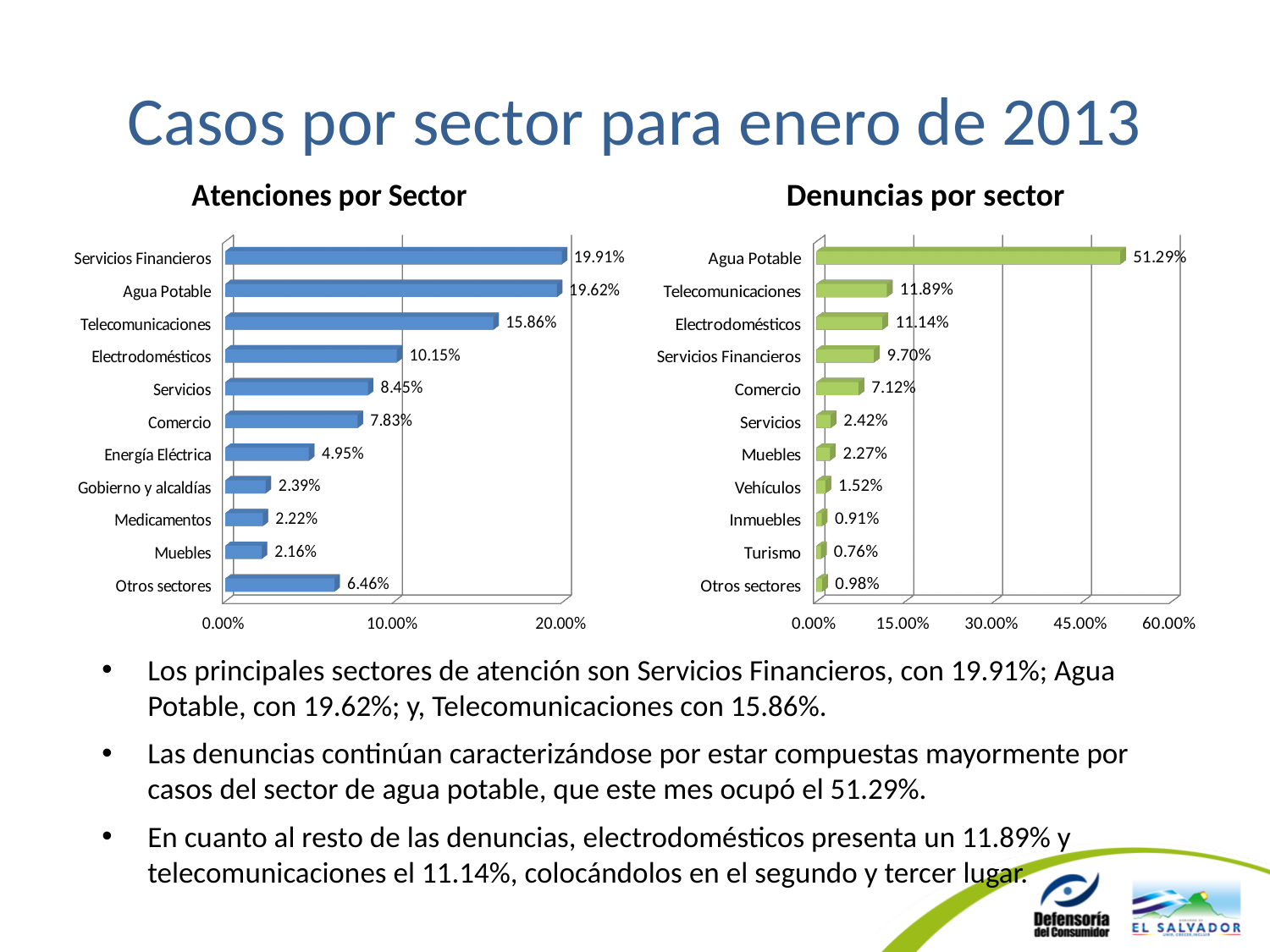
In the 'Denuncias por sector' chart, which sector has the lowest value? Turismo In the 'Atenciones por Sector' chart, what is the value for Otros sectores? 6.46% What colour are the bars in the 'Denuncias por sector' chart? Green In the 'Atenciones por Sector' chart, what is the value for Telecomunicaciones? 15.86% In the 'Atenciones por Sector' chart, which is larger: Servicios or Comercio? Servicios How many sectors are shown in the 'Atenciones por Sector' chart? 11 In the 'Atenciones por Sector' chart, which sector has the highest value? Servicios Financieros In the 'Denuncias por sector' chart, what is the difference between Agua Potable and Telecomunicaciones? 39.40% In the 'Denuncias por sector' chart, what is the value for Comercio? 7.12% In the 'Denuncias por sector' chart, is the value for Agua Potable greater or less than 45.00%? greater In the 'Atenciones por Sector' chart, what is the difference between Servicios Financieros and Agua Potable? 0.29% What kind of chart is 'Denuncias por sector'? Bar chart